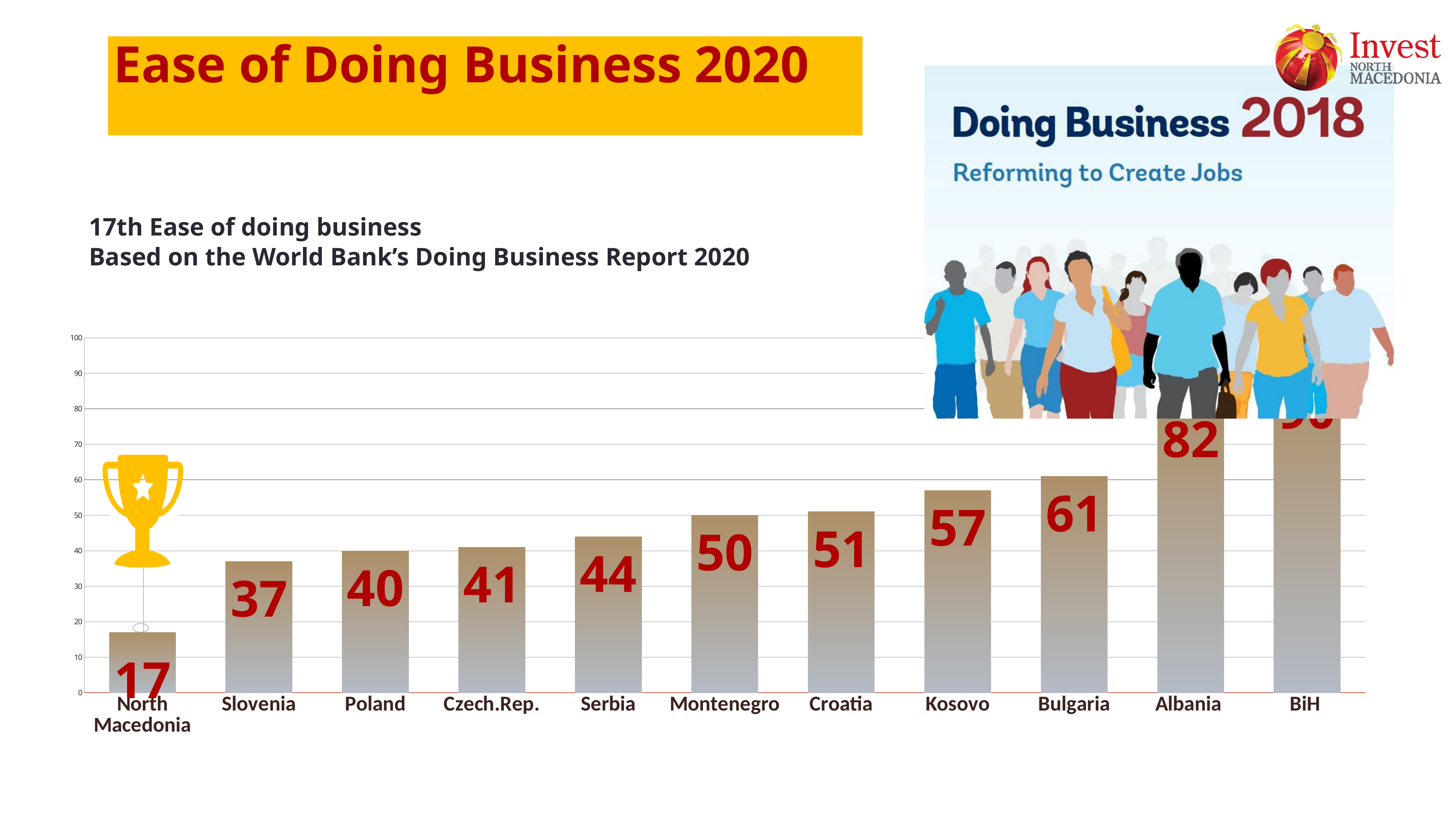
What is the difference between the values for Albania and Bulgaria? 21 What is the value for North Macedonia? 17 What kind of chart is shown on the slide? Bar chart Which country has the lowest value in the chart? North Macedonia What is the value for Slovenia? 37 How many countries are shown in the chart? 11 Is the value for Bulgaria greater or less than 50? greater Do the values rise or fall from left to right along the x axis? Rise Which has a larger value, Montenegro or Poland? Montenegro What is the value for Albania? 82 What is the value for Kosovo? 57 What is the value for Serbia? 44